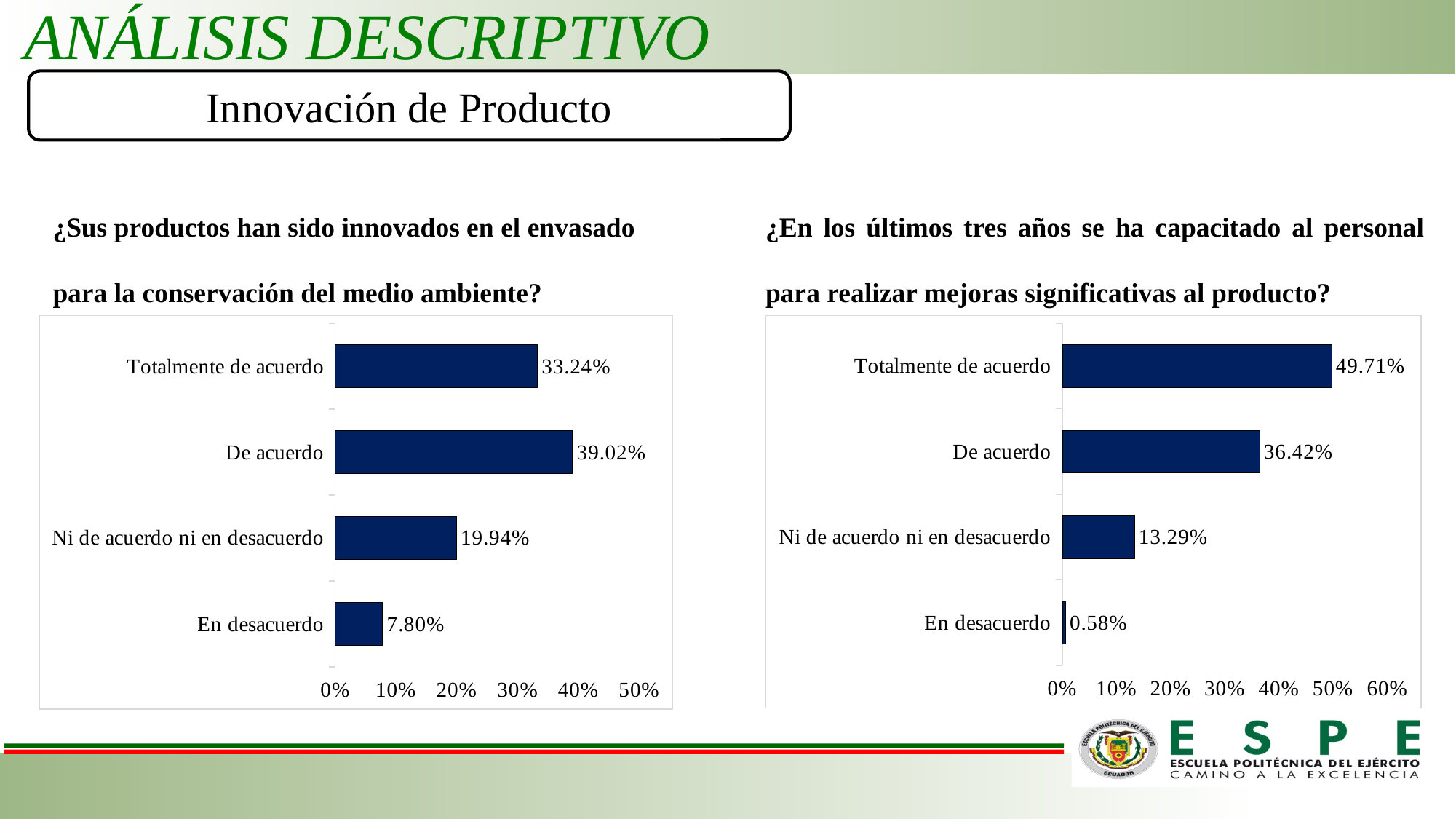
What is the highest tick value on the x axis of the right chart (¿En los últimos tres años se ha capacitado al personal...?)? 60% In the left chart (¿Sus productos han sido innovados en el envasado...?), which category has the highest value? De acuerdo In the left chart (¿Sus productos han sido innovados en el envasado...?), what is the value for 'De acuerdo'? 39.02% In the right chart (¿En los últimos tres años se ha capacitado al personal...?), which is larger: 'De acuerdo' or 'Ni de acuerdo ni en desacuerdo'? De acuerdo In the right chart (¿En los últimos tres años se ha capacitado al personal...?), which category has the lowest value? En desacuerdo How many categories does the left chart (¿Sus productos han sido innovados en el envasado...?) show? 4 In the right chart (¿En los últimos tres años se ha capacitado al personal...?), what is the value for 'Ni de acuerdo ni en desacuerdo'? 13.29% In the left chart (¿Sus productos han sido innovados en el envasado...?), what is the value for 'En desacuerdo'? 7.80% In the right chart (¿En los últimos tres años se ha capacitado al personal...?), what is the value for 'Totalmente de acuerdo'? 49.71% In the right chart (¿En los últimos tres años se ha capacitado al personal...?), what is the difference between 'Totalmente de acuerdo' and 'De acuerdo'? 13.29% In the left chart (¿Sus productos han sido innovados en el envasado...?), what is the difference between 'De acuerdo' and 'Totalmente de acuerdo'? 5.78% What kind of chart is the right chart (¿En los últimos tres años se ha capacitado al personal...?)? Bar chart